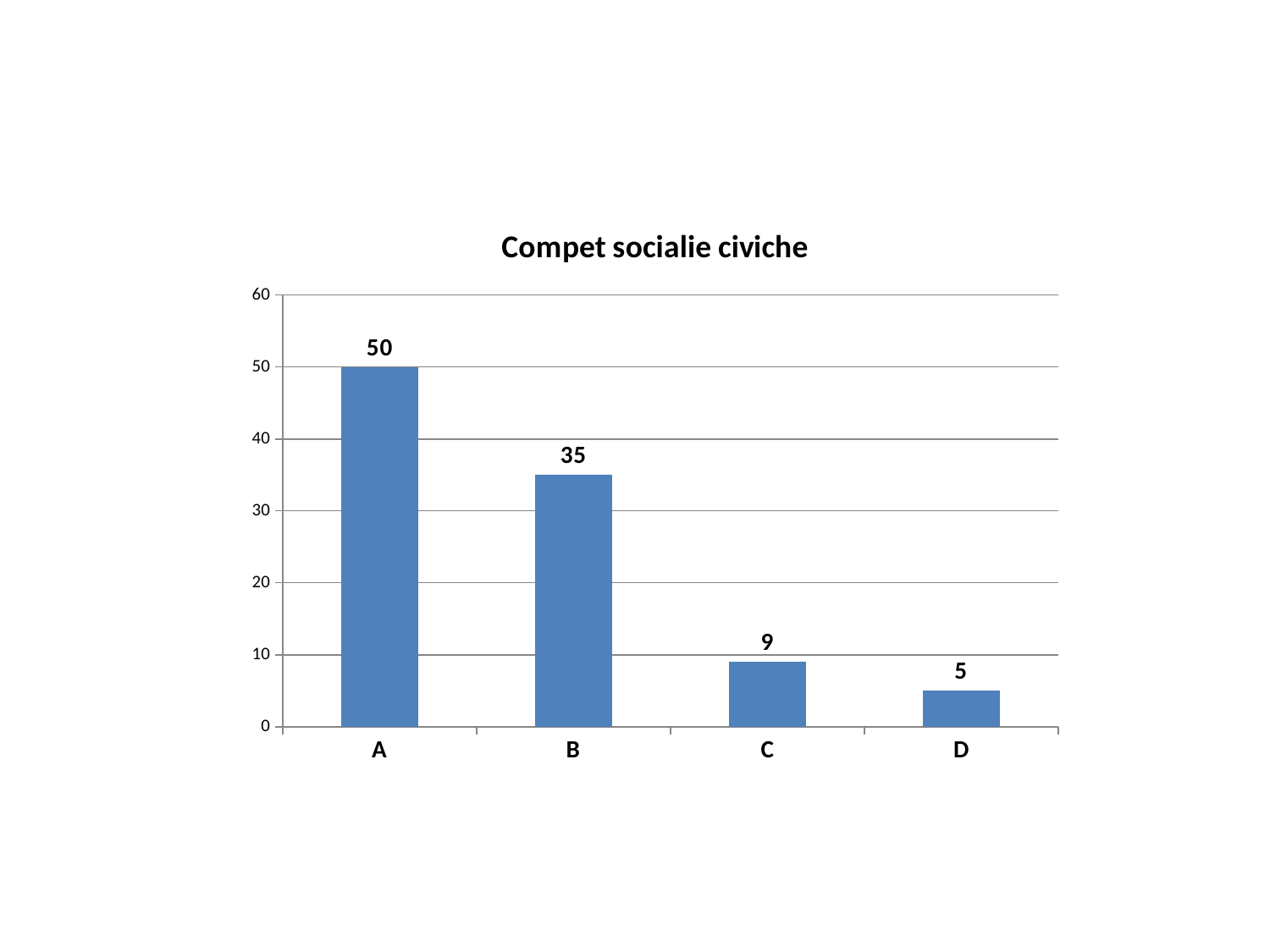
What kind of chart is shown on the slide? Bar chart What is the value for category C? 9 Which category has the lowest value? D What is the value for category A? 50 How many categories are shown on the x axis? 4 What is the value for category B? 35 What is the value for category D? 5 Is the value for B greater or less than 40? less What is the title of the chart? Compet socialie civiche Which category has the highest value? A What is the difference between the values for A and B? 15 Which is larger, the value for C or the value for D? C